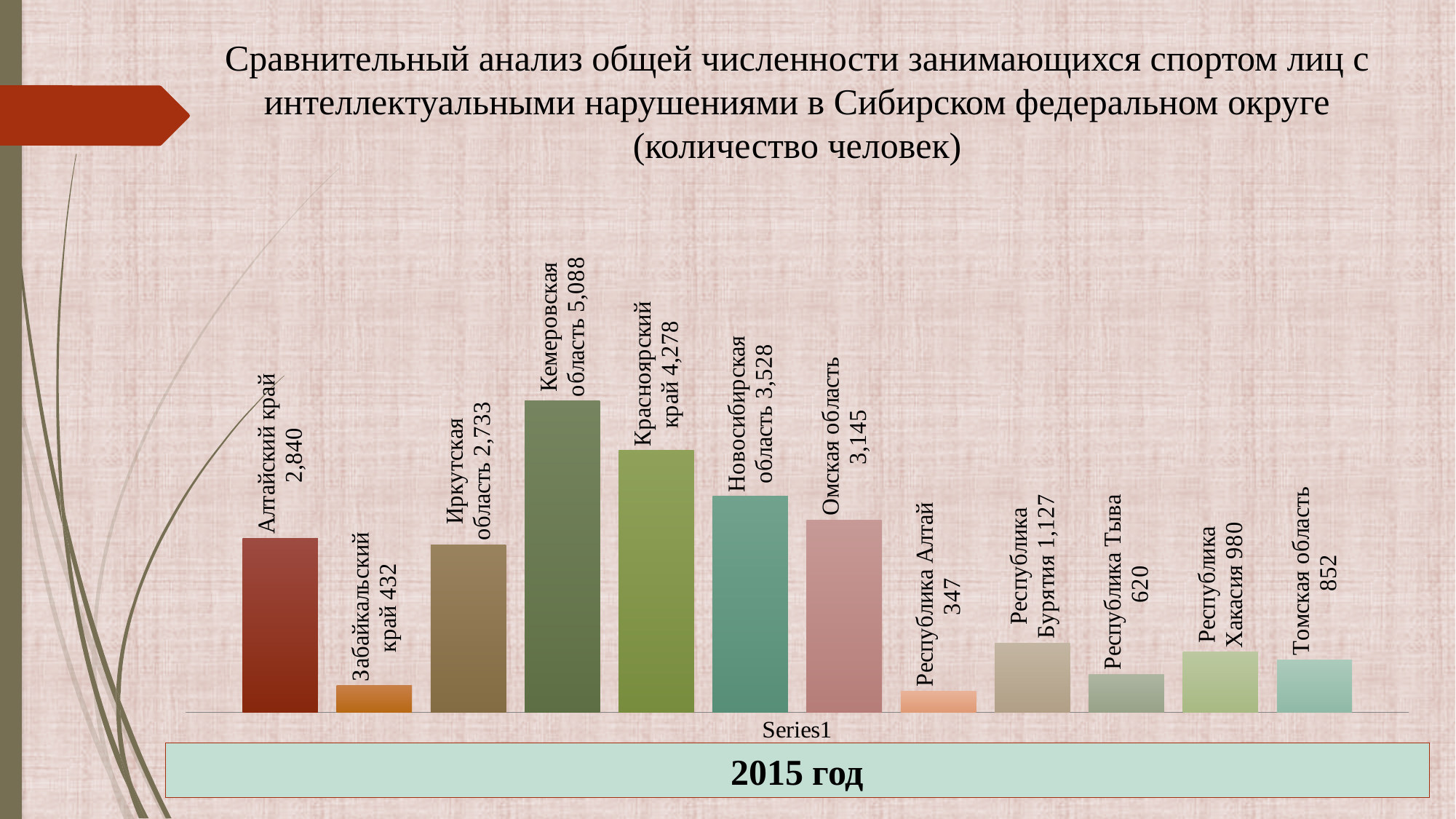
What is the value for Республика Бурятия? 1,127 What is the value for Кемеровская область? 5,088 What is the difference between the values for Алтайский край and Иркутская область? 107 What year is indicated below the chart? 2015 год Which is larger, the value for Омская область or the value for Новосибирская область? Новосибирская область What kind of chart is shown on the slide? Bar chart Which region has the lowest value? Республика Алтай How many regions are shown in the chart? 12 What is the difference between the values for Красноярский край and Новосибирская область? 750 What is the value for Томская область? 852 Which is larger, the value for Республика Хакасия or the value for Республика Тыва? Республика Хакасия Which region has the highest value? Кемеровская область